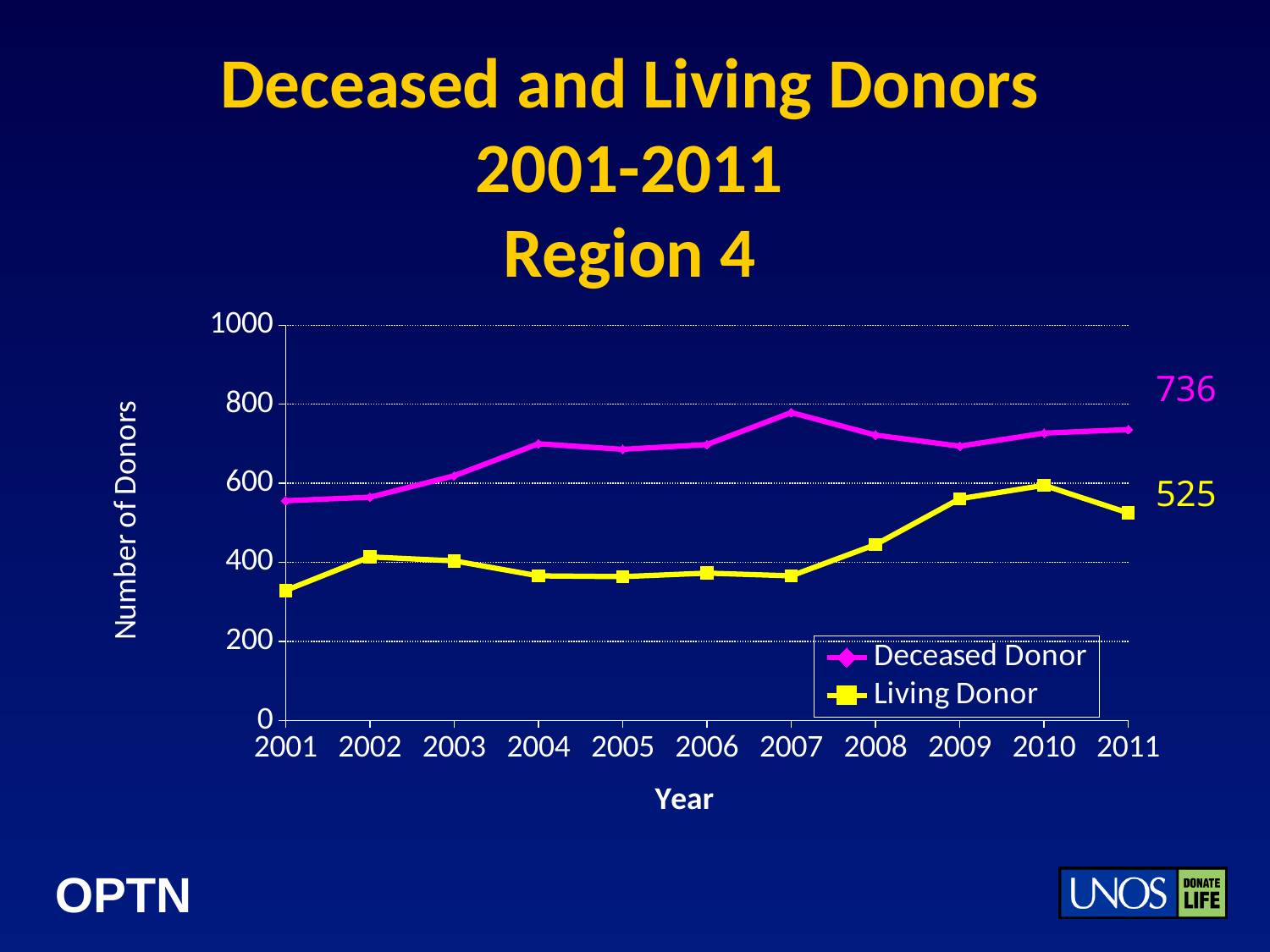
What is the number of Living Donors in 2011? 525 Is the Deceased Donor value for 2001 greater or less than 600? less In which year does the Deceased Donor series reach its highest value? 2007 Is the Living Donor value for 2010 greater or less than 400? greater In which year is the Living Donor series at its lowest? 2001 In 2011, which series has the larger value, Deceased Donor or Living Donor? Deceased Donor How many series does the legend list? 2 What is the difference between the Deceased Donor and Living Donor values in 2011? 211 How many years are shown on the x axis? 11 What kind of chart is shown on the slide? Line chart Is the Living Donor value for 2001 greater or less than 400? less What is the number of Deceased Donors in 2011? 736